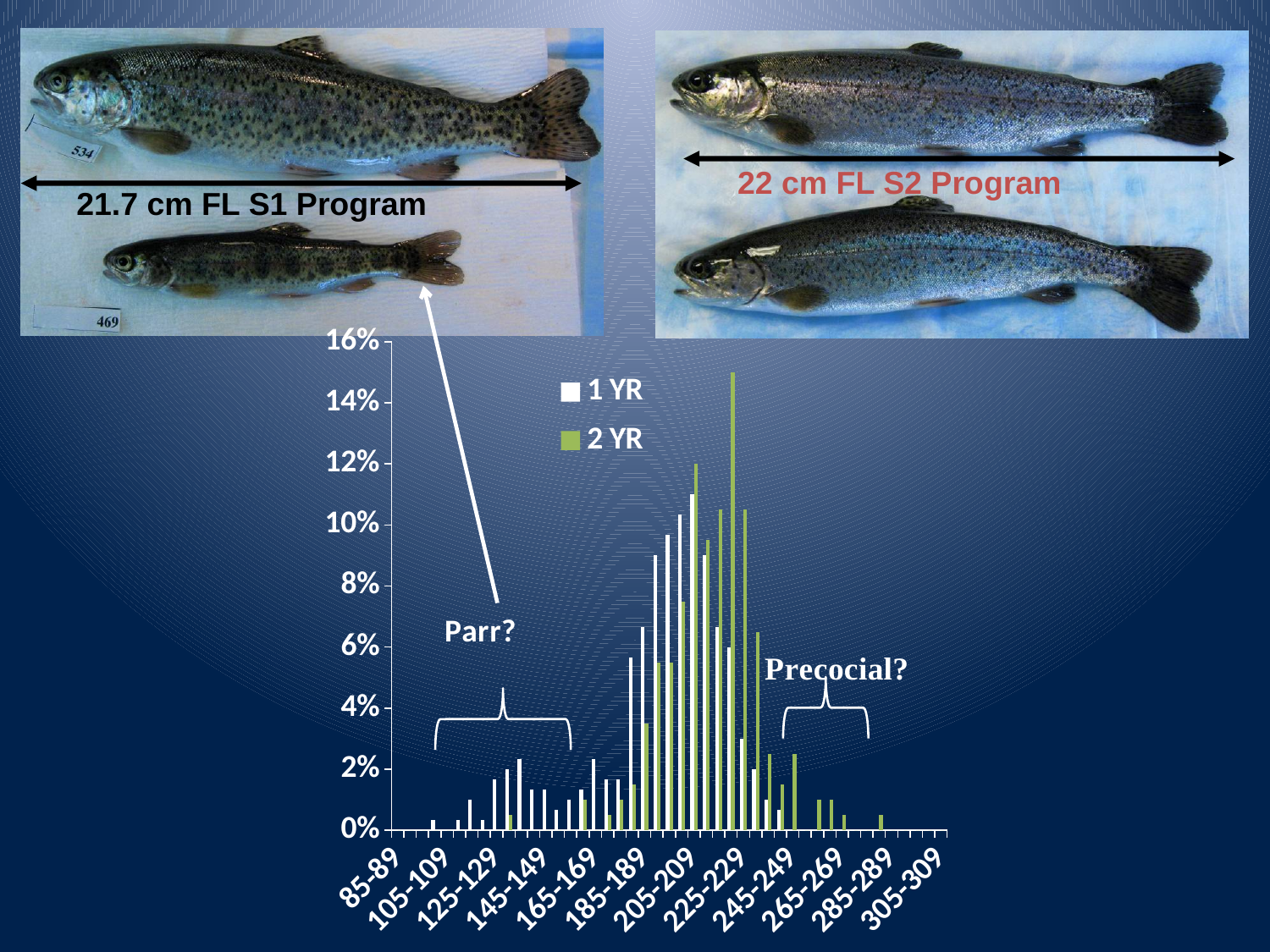
What colour are the bars for the 2 YR series? green Which series contains the tallest bar in the chart, 1 YR or 2 YR? 2 YR What is the highest value shown on the chart's y axis? 16% Is the tallest 2 YR bar greater or less than 14%? greater Is the 1 YR value for the 105-109 bin greater or less than 2%? less What kind of chart is shown on the slide? bar chart Is the 2 YR value for the 285-289 bin greater or less than 2%? less What are the two series named in the chart legend? 1 YR and 2 YR How many series does the chart's legend list? 2